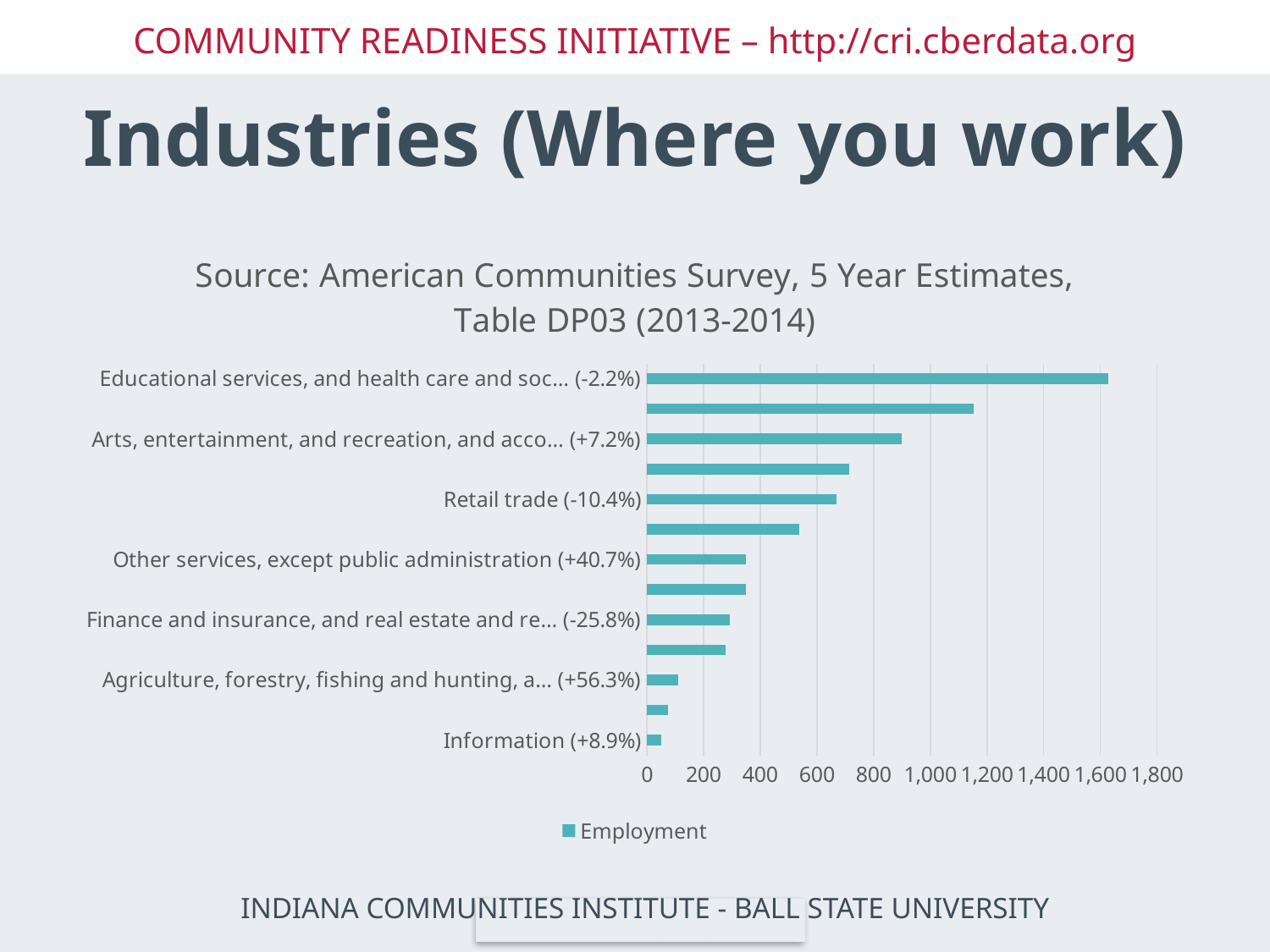
Is the value for Other services, except public administration (+40.7%) greater or less than 400? less Is the value for Educational services, and health care and soc... (-2.2%) greater or less than 1,400? greater Which category has the highest employment value? Educational services, and health care and soc... (-2.2%) How many bars are plotted in the chart? 13 Which labeled category has the lowest employment value? Information (+8.9%) Is the value for Retail trade (-10.4%) greater or less than 600? greater What kind of chart is shown on the slide? bar chart Which has a larger employment value, Retail trade (-10.4%) or Arts, entertainment, and recreation, and acco... (+7.2%)? Arts, entertainment, and recreation, and acco... (+7.2%) What is the name of the series shown in the legend? Employment How many series does the legend list? 1